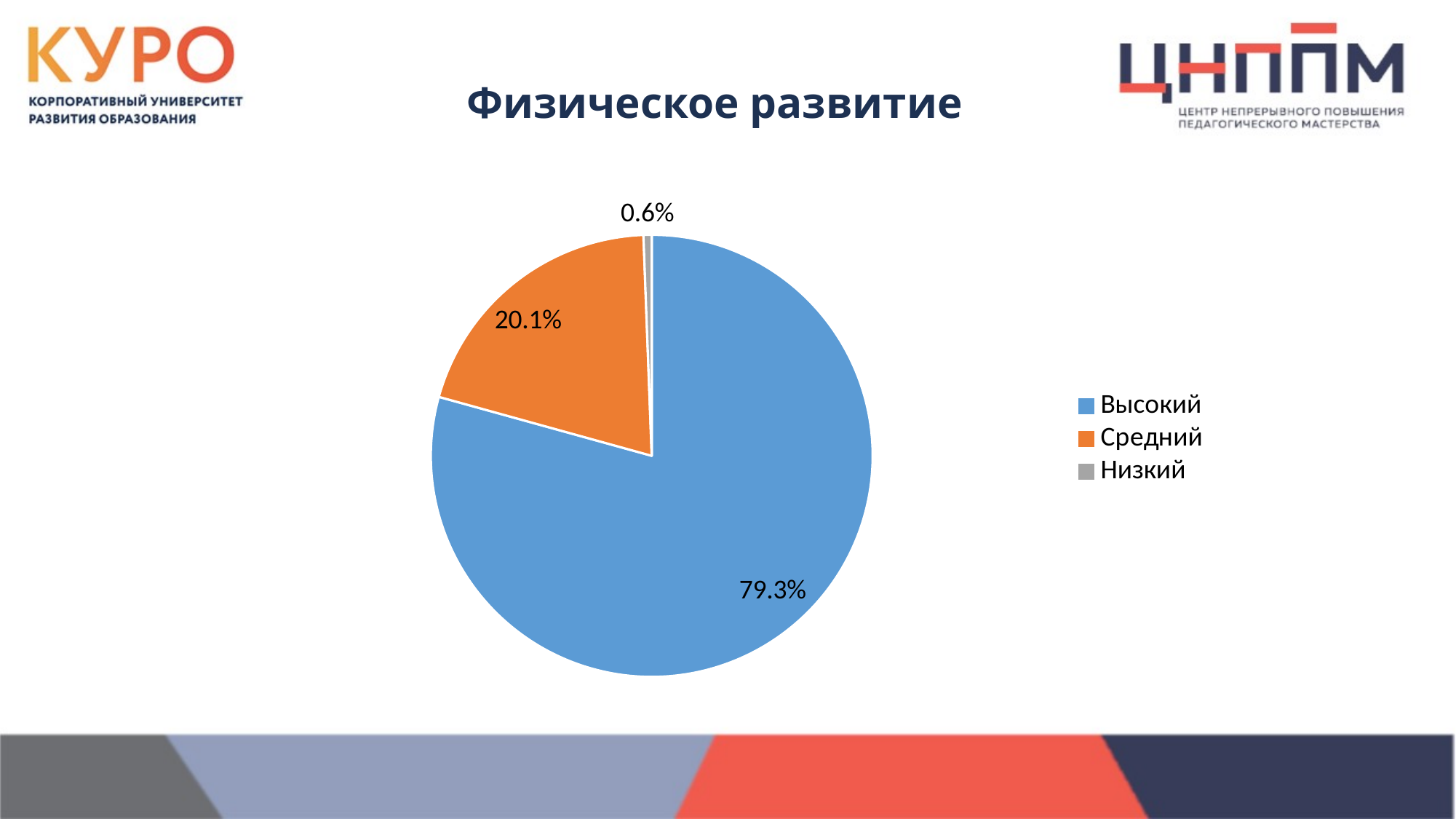
Which is larger, the value for Средний or the value for Низкий? Средний Which category has the smallest share of the pie? Низкий What is the title of the slide? Физическое развитие How many entries does the legend list? 3 What is the difference between the values for Высокий and Средний? 59.2% How many slices does the pie chart have? 3 What type of chart is shown on the slide? pie chart What is the value for Средний? 20.1% What colour is the slice for Средний? orange Which category has the largest share of the pie? Высокий What is the value for Низкий? 0.6% What is the value for Высокий? 79.3%